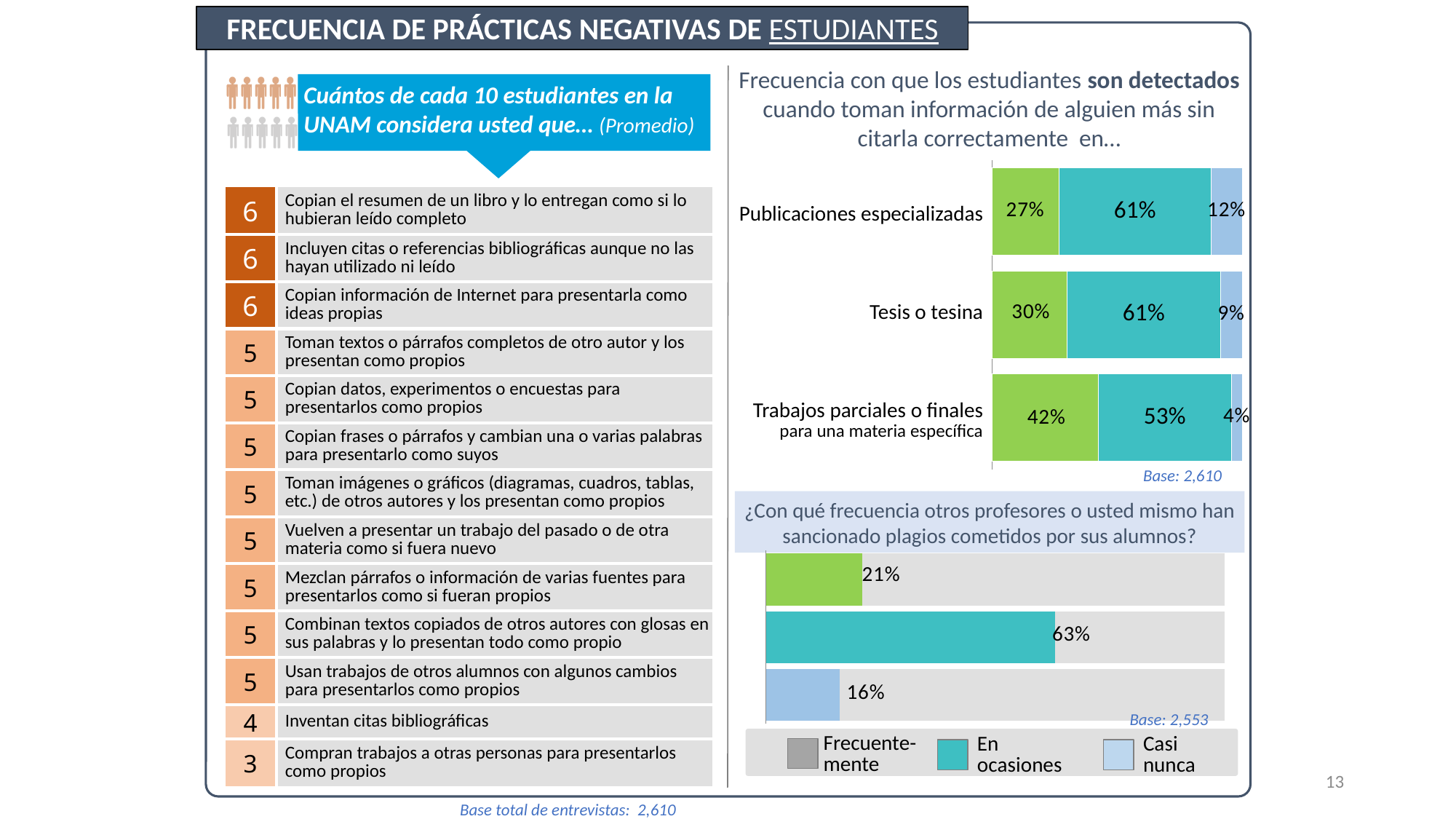
In the bar chart under '¿Con qué frecuencia otros profesores o usted mismo han sancionado plagios...', what is the difference between the 63% bar and the 21% bar? 42% In the bar chart under '¿Con qué frecuencia otros profesores o usted mismo han sancionado plagios...', which bar is the smallest? 16% In the stacked bar chart 'Frecuencia con que los estudiantes son detectados...', what is the total of the three segments for 'Tesis o tesina'? 100% In the stacked bar chart 'Frecuencia con que los estudiantes son detectados...', what percentage is shown for 'En ocasiones' for 'Tesis o tesina'? 61% In the stacked bar chart 'Frecuencia con que los estudiantes son detectados...', what is the 'Casi nunca' value for 'Publicaciones especializadas'? 12% In the bar chart under '¿Con qué frecuencia otros profesores o usted mismo han sancionado plagios...', what is the value of the teal 'En ocasiones' bar? 63% In the stacked bar chart 'Frecuencia con que los estudiantes son detectados...', how many categories are shown? 3 How many entries does the legend at the bottom right of the slide list? 3 In the stacked bar chart 'Frecuencia con que los estudiantes son detectados...', which category has the highest first (green) segment value? Trabajos parciales o finales In the stacked bar chart 'Frecuencia con que los estudiantes son detectados...', which category has the lowest 'Casi nunca' value? Trabajos parciales o finales In the stacked bar chart 'Frecuencia con que los estudiantes son detectados...', what is the first (green) segment value for 'Trabajos parciales o finales'? 42% In the stacked bar chart 'Frecuencia con que los estudiantes son detectados...', what is the difference between the green segment values for 'Trabajos parciales o finales' and 'Publicaciones especializadas'? 15%